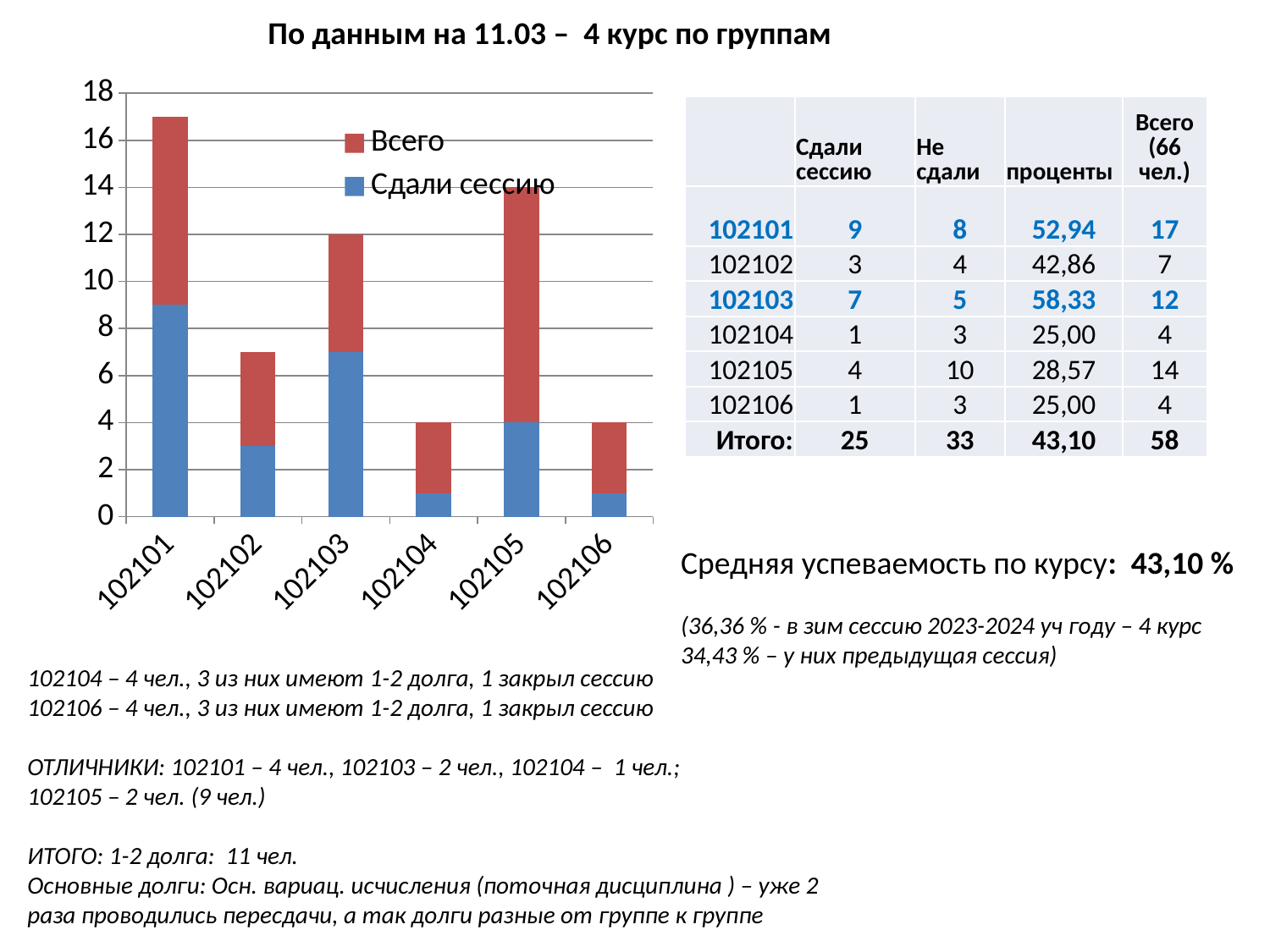
What kind of chart is shown on the slide? Stacked bar chart What is the Сдали сессию value for group 102101? 9 Is the total bar height for group 102102 greater or less than 8? less What are the two legend entries of the chart? Всего and Сдали сессию Is the total bar height for group 102105 greater or less than 12? greater What is the Сдали сессию value for group 102105? 4 What is the difference between the total bar heights of groups 102101 and 102102? 10 How many series does the chart legend list? 2 How many groups (categories) are shown on the x axis of the chart? 6 Which group has the tallest bar (highest Всего) in the chart? 102101 Which bar is taller, 102103 or 102105? 102105 What is the total height (Всего) of the bar for group 102103? 12